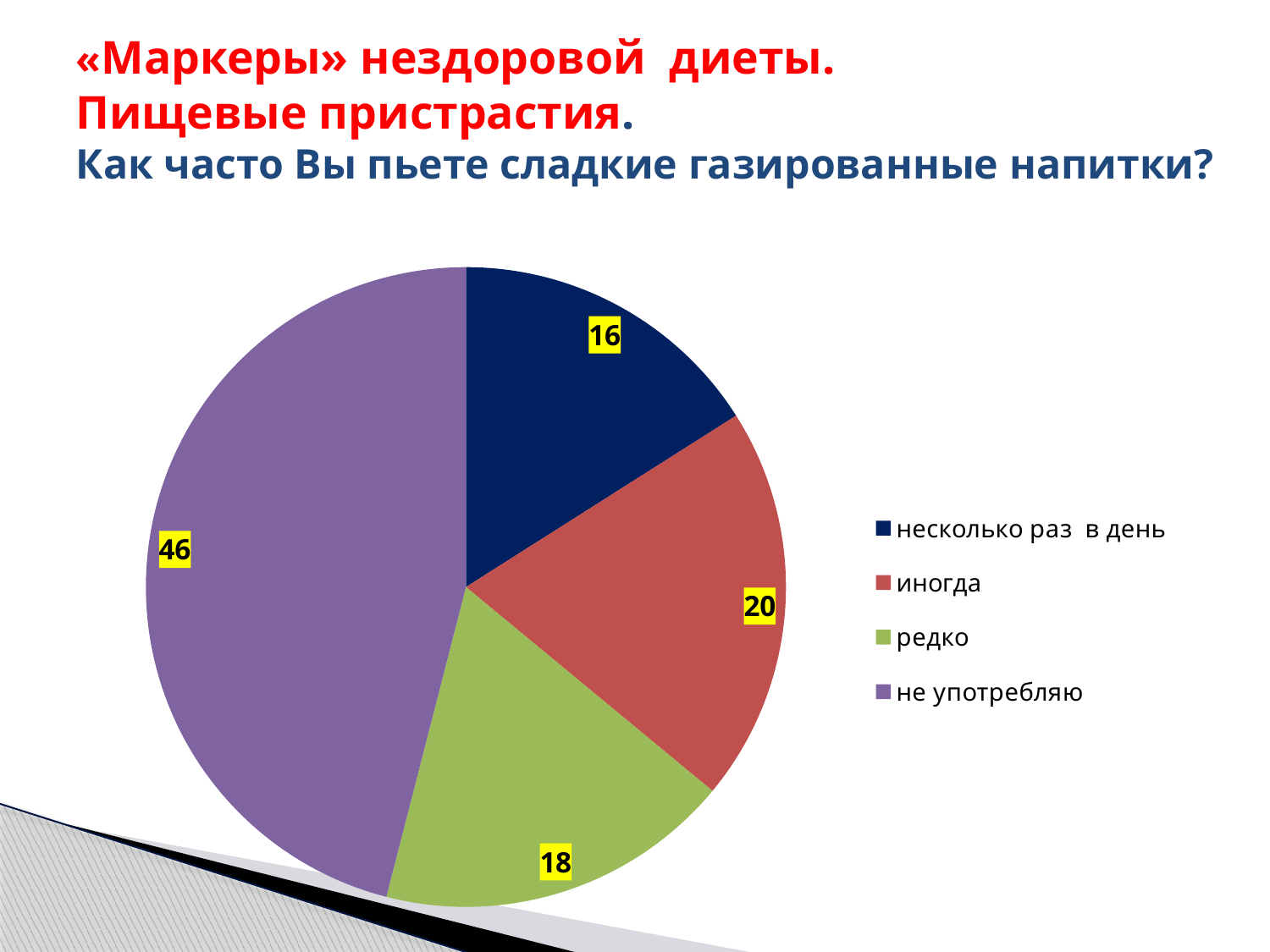
Which colour is used for the "редко" slice in the pie chart? green What value is shown for the "редко" slice? 18 Which is larger, the value for "иногда" or the value for "редко"? иногда What share of the pie does the "не употребляю" slice represent? 46% What value is shown for the "несколько раз в день" slice? 16 What type of chart is shown on the slide? pie chart How many slices does the pie chart have? 4 Which category has the smallest slice of the pie chart? несколько раз в день What is the difference between the values for "не употребляю" and "иногда"? 26 Which category has the largest slice of the pie chart? не употребляю What value is shown for the "не употребляю" slice of the pie chart? 46 What value is shown for the "иногда" slice? 20